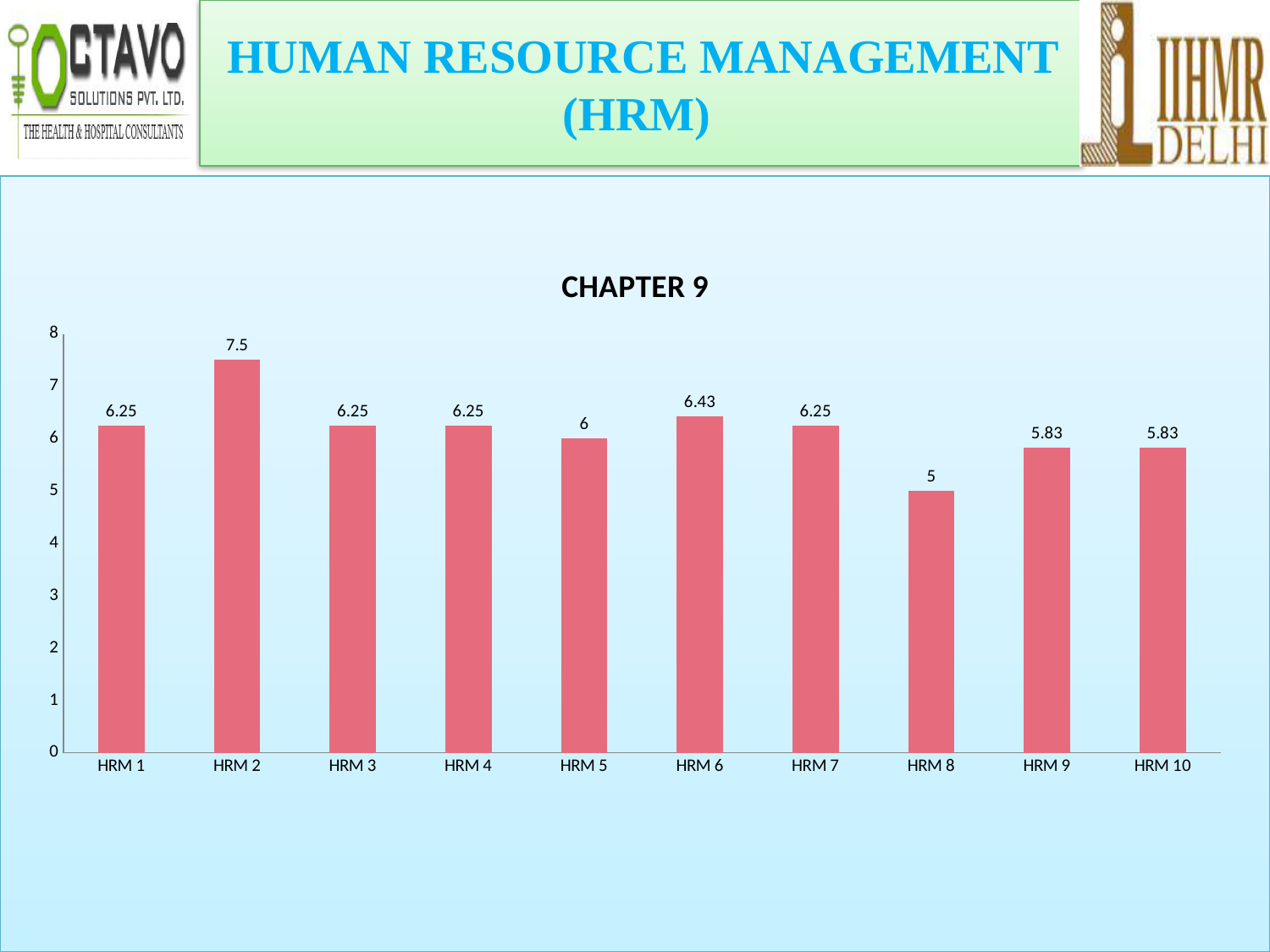
What type of chart is shown on the slide? bar chart Which is larger, the value for HRM 5 or the value for HRM 9? HRM 5 How many categories are shown on the x axis? 10 What is the difference between the values for HRM 6 and HRM 9? 0.6 Which category has the highest value? HRM 2 What is the difference between the values for HRM 2 and HRM 8? 2.5 What is the value for HRM 10? 5.83 What is the value for HRM 8? 5 What is the value for HRM 6? 6.43 What is the value for HRM 2? 7.5 Which category has the lowest value? HRM 8 Is the value for HRM 2 greater or less than 7? greater